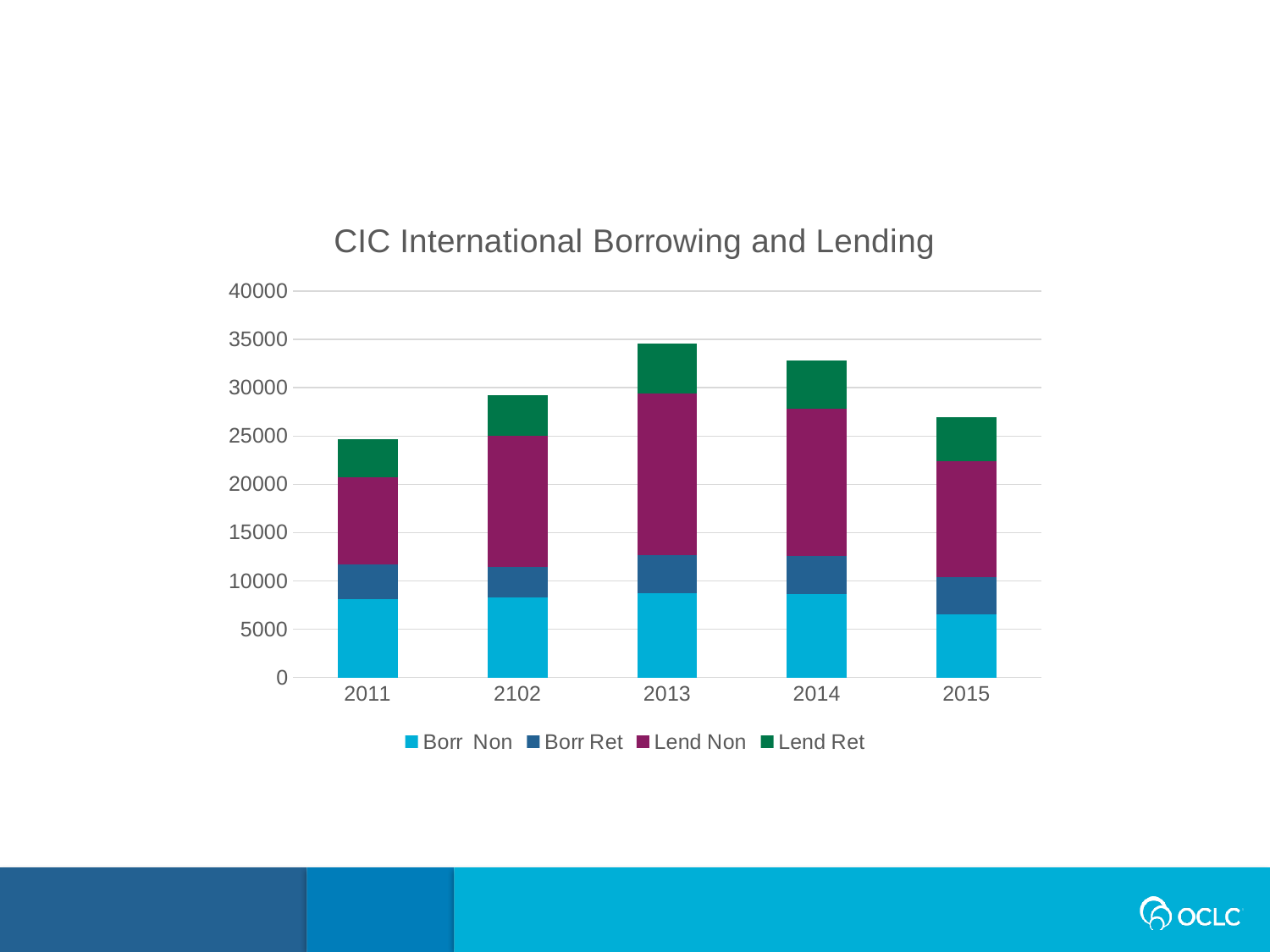
Which category has the highest stacked total? 2013 Which series is shown in green in the legend? Lend Ret What is the title of the chart? CIC International Borrowing and Lending Which category has the lowest stacked total? 2011 What kind of chart is shown on the slide? bar chart How many series does the legend list? 4 Is the stacked total for 2015 greater or less than 30000? less Is the stacked total for 2013 greater or less than 30000? greater How many categories are shown along the x axis? 5 Do the stacked totals rise or fall from 2013 to 2015? fall Which has the larger stacked total, 2013 or 2014? 2013 Is the Borr Non value for 2015 greater or less than 10000? less